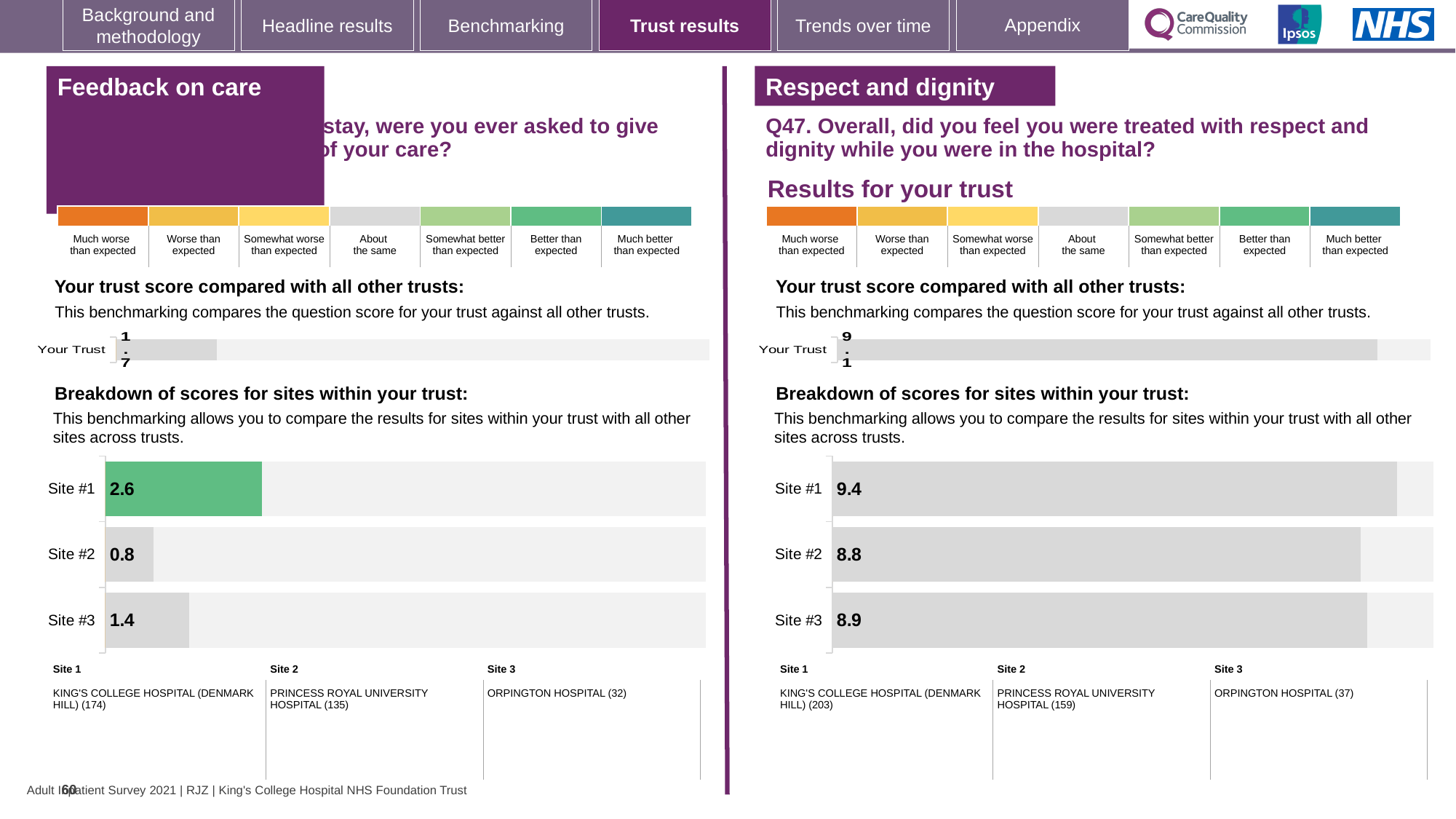
In the 'Feedback on care' site breakdown chart, what is the difference between the scores for Site #1 and Site #3? 1.2 In the 'Feedback on care' site breakdown chart, what is the score for Site #1? 2.6 In the 'Feedback on care' site breakdown chart, which site's bar is coloured green? Site #1 In the 'Respect and dignity' site breakdown chart, is the score for Site #3 larger or smaller than the score for Site #2? larger In the 'Feedback on care' site breakdown chart, which site has the lowest score? Site #2 How many sites are shown in the 'Feedback on care' site breakdown chart? 3 In the 'Feedback on care' panel, what is the 'Your Trust' score shown in the trust comparison chart? 1.7 In the 'Respect and dignity' site breakdown chart, which site has the highest score? Site #1 In the 'Respect and dignity' panel, what is the 'Your Trust' score shown in the trust comparison chart? 9.1 What type of chart is used for the site breakdown in the 'Respect and dignity' panel? bar chart In the 'Respect and dignity' site breakdown chart, what is the score for Site #2? 8.8 In the 'Respect and dignity' site breakdown chart, what is the difference between the scores for Site #1 and Site #2? 0.6